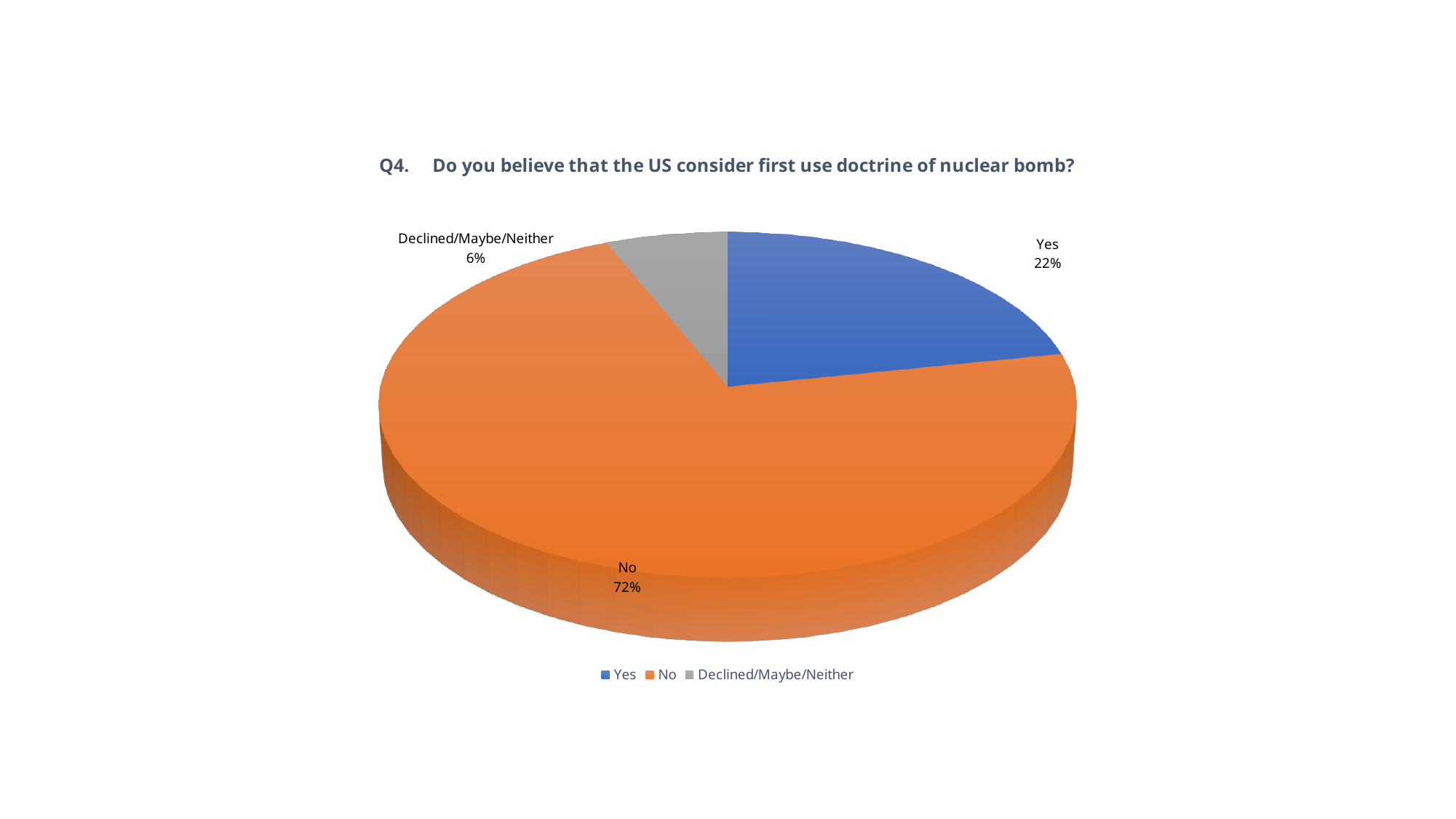
How many slices does the pie chart have? 3 What is the difference in percentage points between "No" and "Yes"? 50 What is the difference in percentage points between "Yes" and "Declined/Maybe/Neither"? 16 How many entries does the legend list? 3 Which response has the smallest share of the pie? Declined/Maybe/Neither What percentage is shown for "Declined/Maybe/Neither"? 6% Which response has the largest share of the pie? No What percentage of respondents answered "Yes"? 22% What percentage of respondents answered "No"? 72% What kind of chart is shown on the slide? Pie chart Which is larger, the share for "Yes" or the share for "Declined/Maybe/Neither"? Yes What colour is the "No" slice? Orange